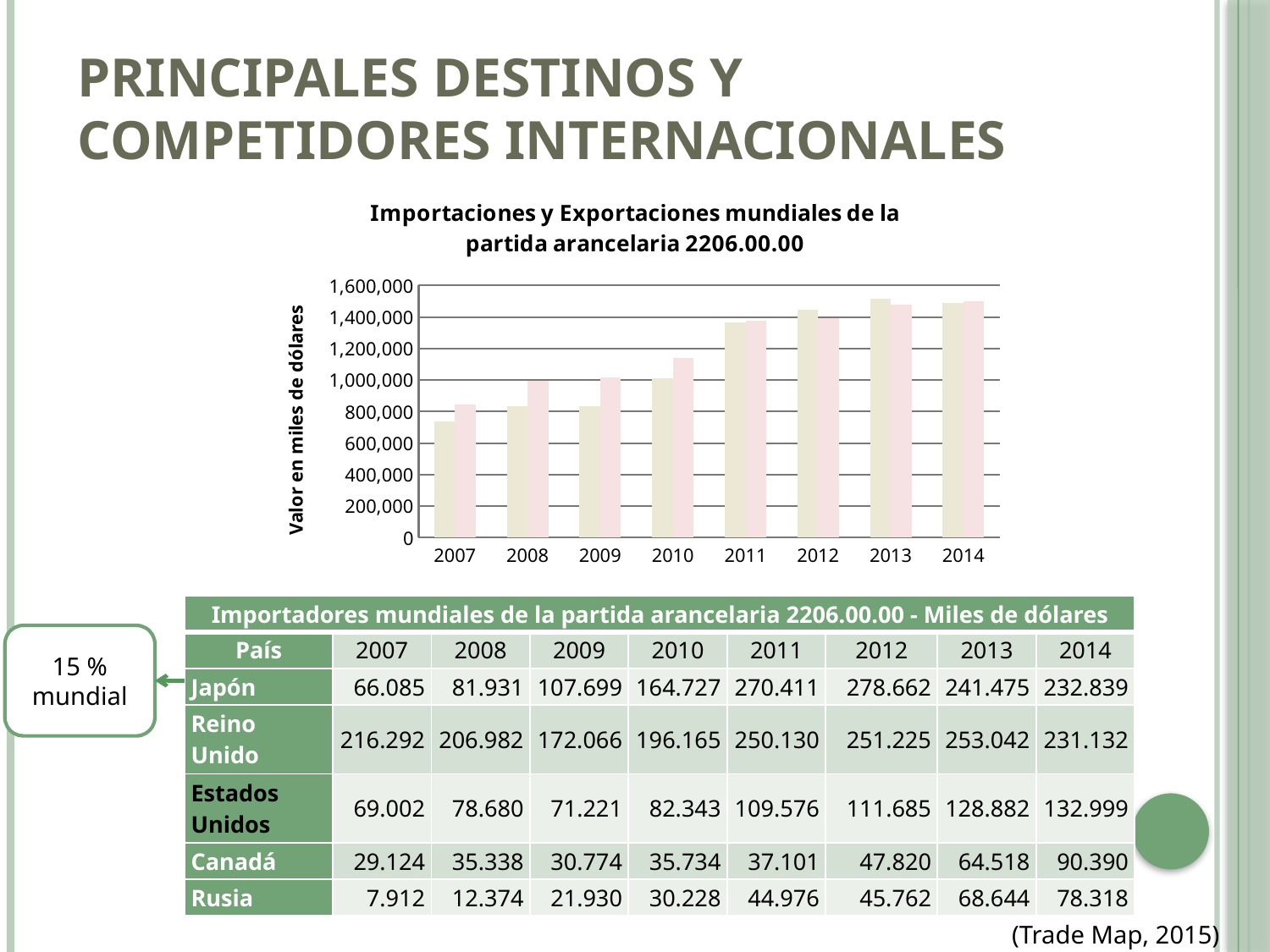
What is the label of the chart's vertical axis? Valor en miles de dólares Which year has the lowest bars in the chart? 2007 What kind of chart is shown on the slide? bar chart What is the title of the chart? Importaciones y Exportaciones mundiales de la partida arancelaria 2206.00.00 How many years are shown on the x axis of the chart? 8 How many bars are plotted for each year in the chart? 2 Are the bars for 2008 greater or less than 1,200,000? less Are the bars for 2007 greater or less than 1,000,000? less Are the bars for 2013 greater or less than 1,400,000? greater Do the values in the chart generally rise or fall from 2007 to 2014? rise Which year has larger bars in the chart, 2007 or 2014? 2014